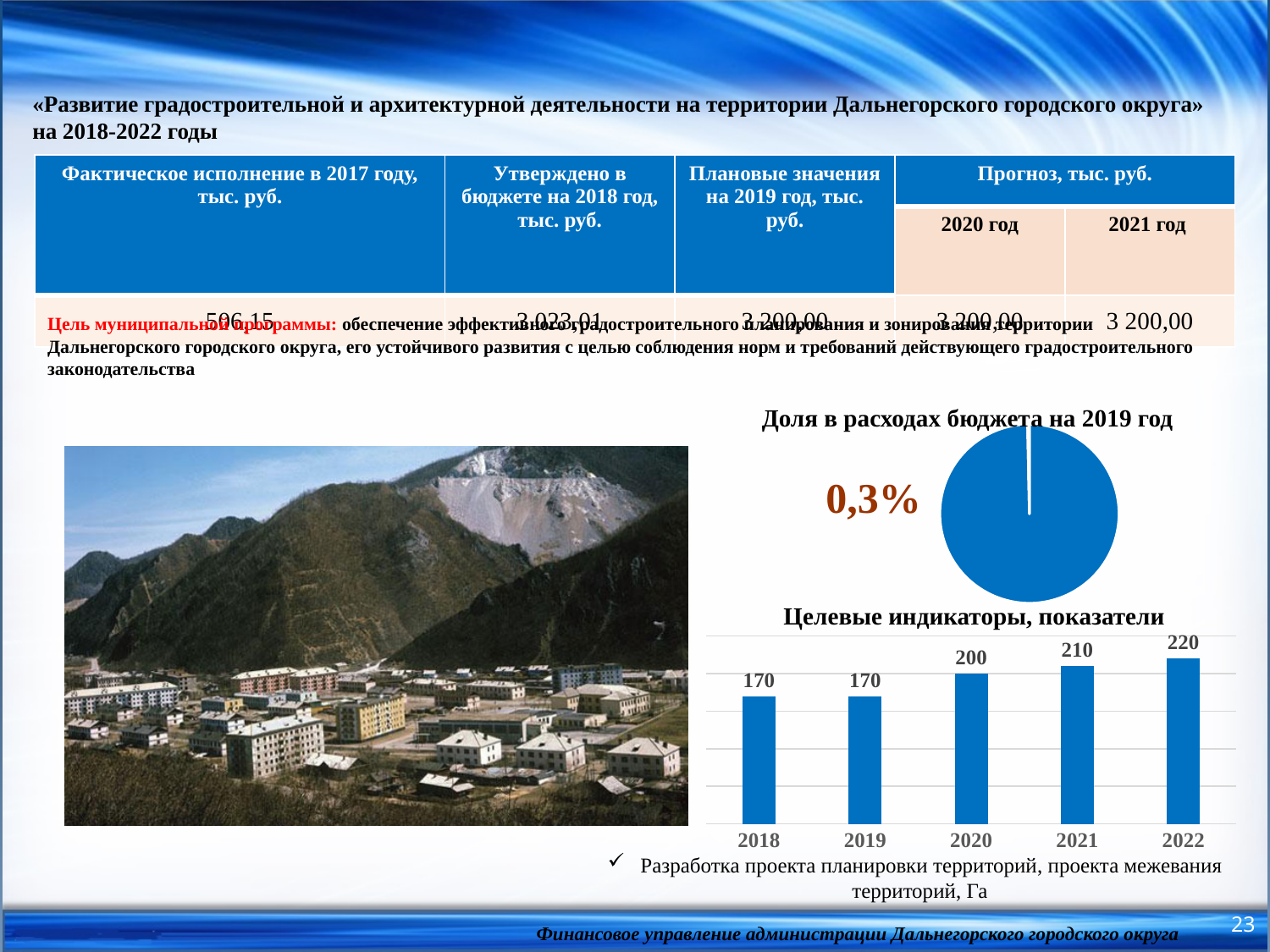
What kind of chart is 'Целевые индикаторы, показатели'? bar chart In the bar chart 'Целевые индикаторы, показатели', do the values generally rise or fall from 2018 to 2022? rise In the bar chart 'Целевые индикаторы, показатели', what is the value for 2018? 170 In the bar chart 'Целевые индикаторы, показатели', what is the difference between the values for 2022 and 2018? 50 In the bar chart 'Целевые индикаторы, показатели', which year has the highest value? 2022 In the bar chart 'Целевые индикаторы, показатели', what is the value for 2020? 200 What share is shown next to the pie chart 'Доля в расходах бюджета на 2019 год'? 0,3% What kind of chart is 'Доля в расходах бюджета на 2019 год'? pie chart In the bar chart 'Целевые индикаторы, показатели', what is the difference between the values for 2021 and 2020? 10 In the bar chart 'Целевые индикаторы, показатели', what is the value for 2022? 220 In the bar chart 'Целевые индикаторы, показатели', which is larger, the value for 2021 or the value for 2019? 2021 How many bars are in the bar chart 'Целевые индикаторы, показатели'? 5